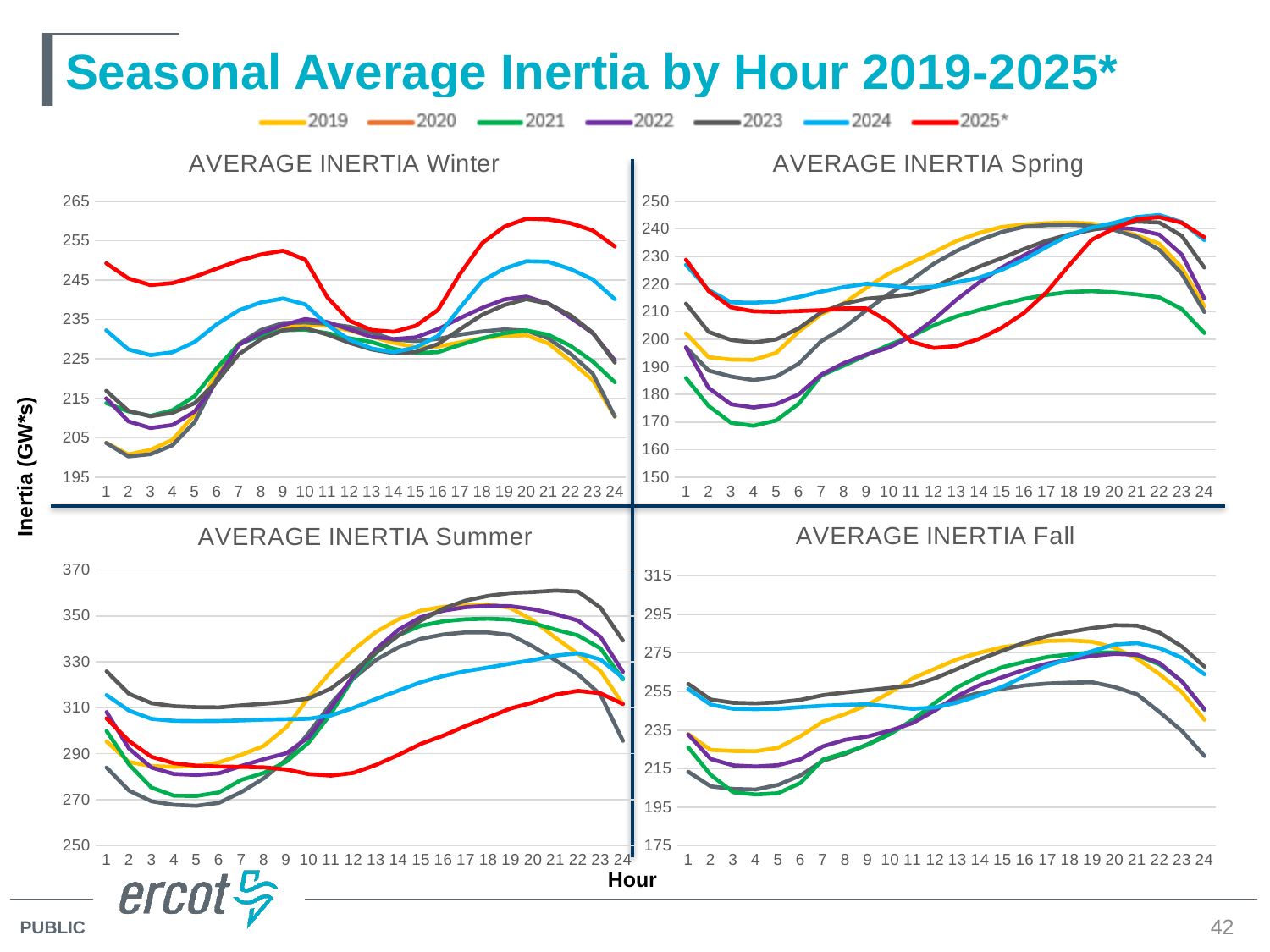
In the AVERAGE INERTIA Spring chart, which year has the lowest value at hour 4? 2021 In the AVERAGE INERTIA Spring chart, does the 2019 line rise or fall from hour 1 to hour 18? rise In the AVERAGE INERTIA Summer chart, which year has the lowest value at hour 20? 2025* In the AVERAGE INERTIA Winter chart, which year has the highest value at hour 20? 2025* How many hours are plotted along the x axis of the AVERAGE INERTIA Summer chart? 24 What is the label on the shared vertical axis of the charts? Inertia (GW*s) In the AVERAGE INERTIA Spring chart, is the value for 2025* at hour 12 greater or less than 210? less In the AVERAGE INERTIA Summer chart, is the value for 2023 at hour 22 greater or less than 350? greater What kind of chart is the AVERAGE INERTIA Winter chart? line chart In the AVERAGE INERTIA Winter chart, is the value for 2025* at hour 20 greater or less than 255? greater How many series does the legend at the top of the slide list? 7